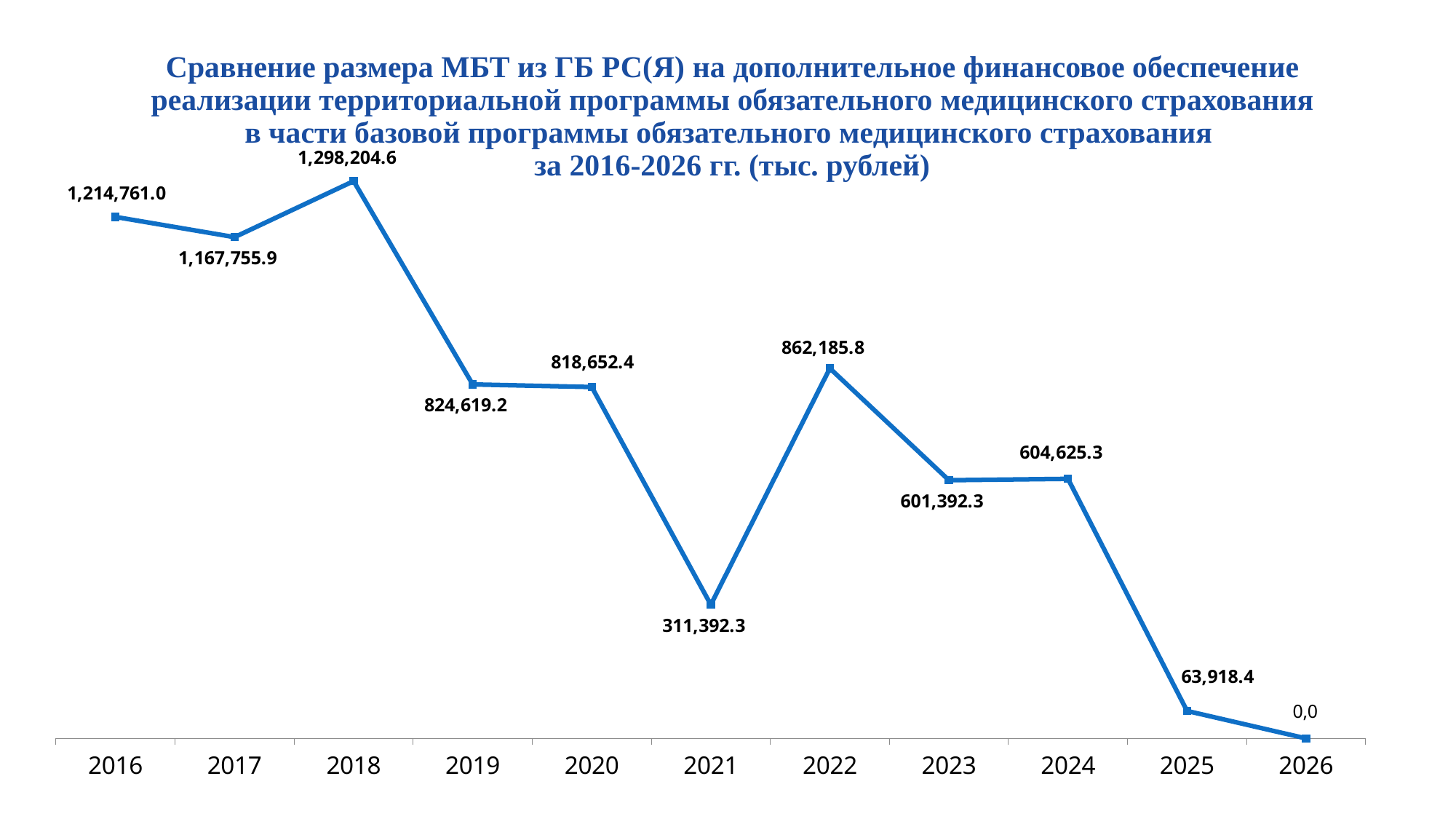
Do the values generally rise or fall from 2016 to 2026? Fall What is the value for 2025? 63,918.4 What is the difference between the values for 2018 and 2017? 130,448.7 What kind of chart is shown on the slide? Line chart Which is larger, the value for 2022 or the value for 2019? 2022 What is the value for 2023? 601,392.3 How many years are plotted on the chart? 11 What is the difference between the values for 2022 and 2021? 550,793.5 Which year has the highest value? 2018 Which year has the lowest value? 2026 What is the value for 2021? 311,392.3 What is the value for 2018? 1,298,204.6